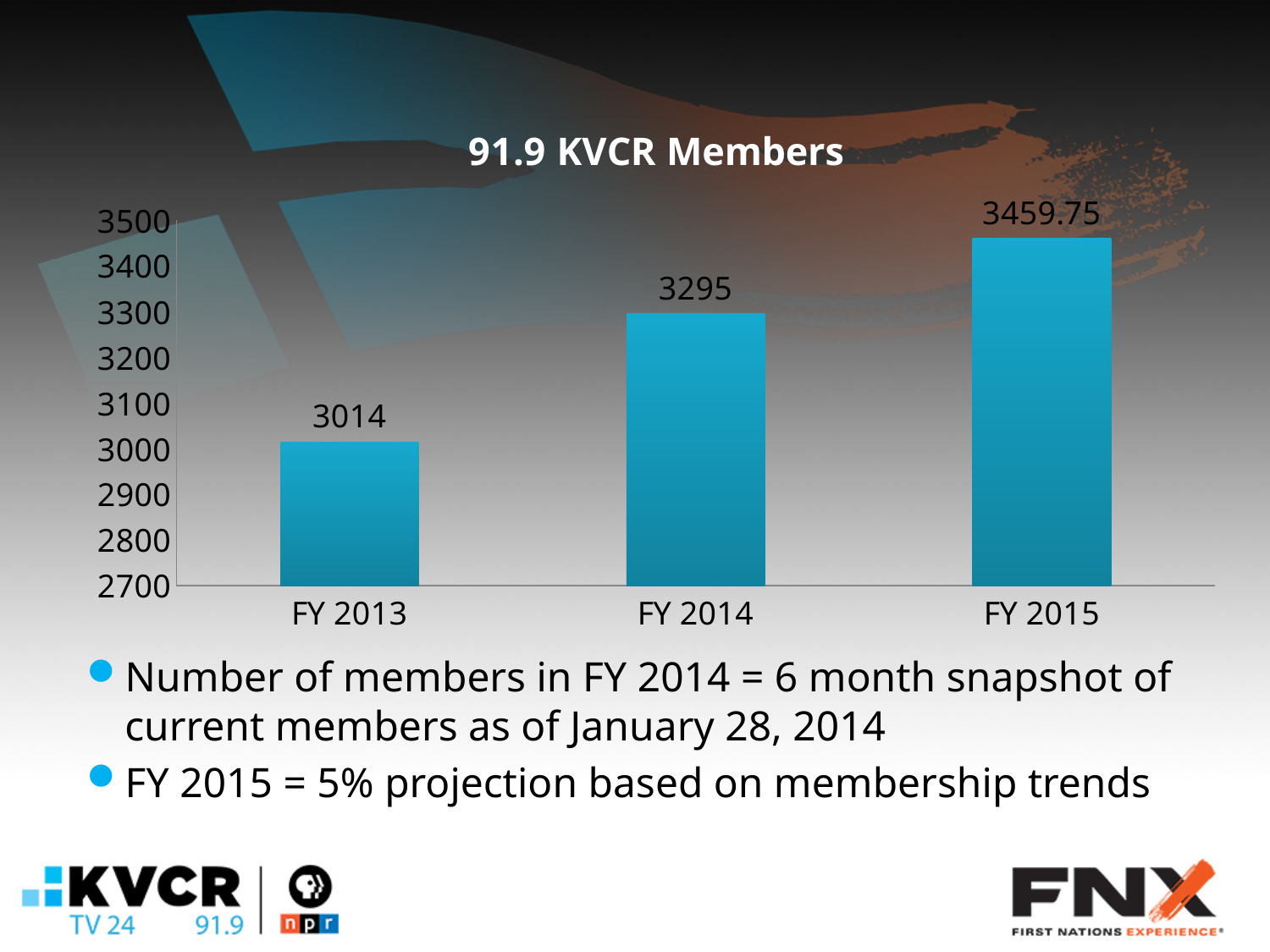
Which fiscal year has the highest number of members? FY 2015 What is the value for FY 2013? 3014 Do the values rise or fall from FY 2013 to FY 2015? rise What is the value for FY 2015? 3459.75 How many fiscal years are shown on the chart? 3 Is the value for FY 2015 greater or less than 3400? greater What kind of chart is shown on the slide? bar chart Which fiscal year has the lowest number of members? FY 2013 What is the value for FY 2014? 3295 What is the difference between the FY 2015 and FY 2014 values? 164.75 What is the difference between the FY 2014 and FY 2013 values? 281 Which is larger, the value for FY 2013 or FY 2014? FY 2014